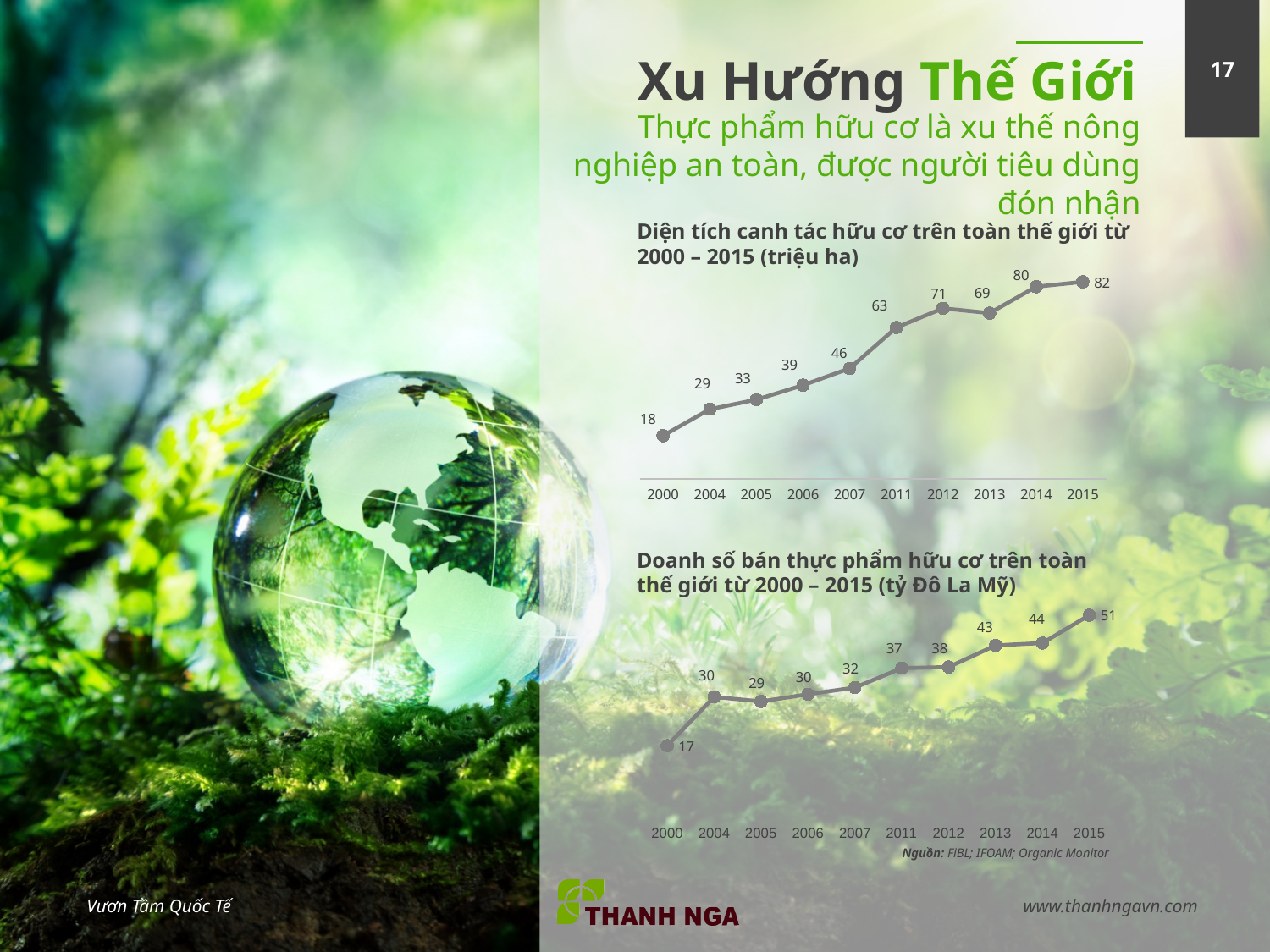
How many data points are plotted in the top chart (organic farming area worldwide)? 10 In the bottom chart (organic food sales worldwide), which year has the highest value? 2015 In the top chart (organic farming area worldwide), which year has the lowest value? 2000 In the top chart (organic farming area worldwide), which is larger, the value for 2012 or the value for 2013? 2012 In the bottom chart (organic food sales worldwide), what is the difference between the 2015 value and the 2014 value? 7 In the bottom chart (organic food sales worldwide), do the values generally rise or fall from 2000 to 2015? Rise In the bottom chart (organic food sales worldwide), what is the value for 2013? 43 What type of chart is the top chart (organic farming area worldwide)? Line chart In the top chart (organic farming area worldwide), what is the difference between the 2015 value and the 2000 value? 64 What unit is given in the title of the bottom chart (organic food sales worldwide)? tỷ Đô La Mỹ In the top chart (organic farming area worldwide), what is the value for 2007? 46 In the top chart (organic farming area worldwide), what is the value for 2015? 82